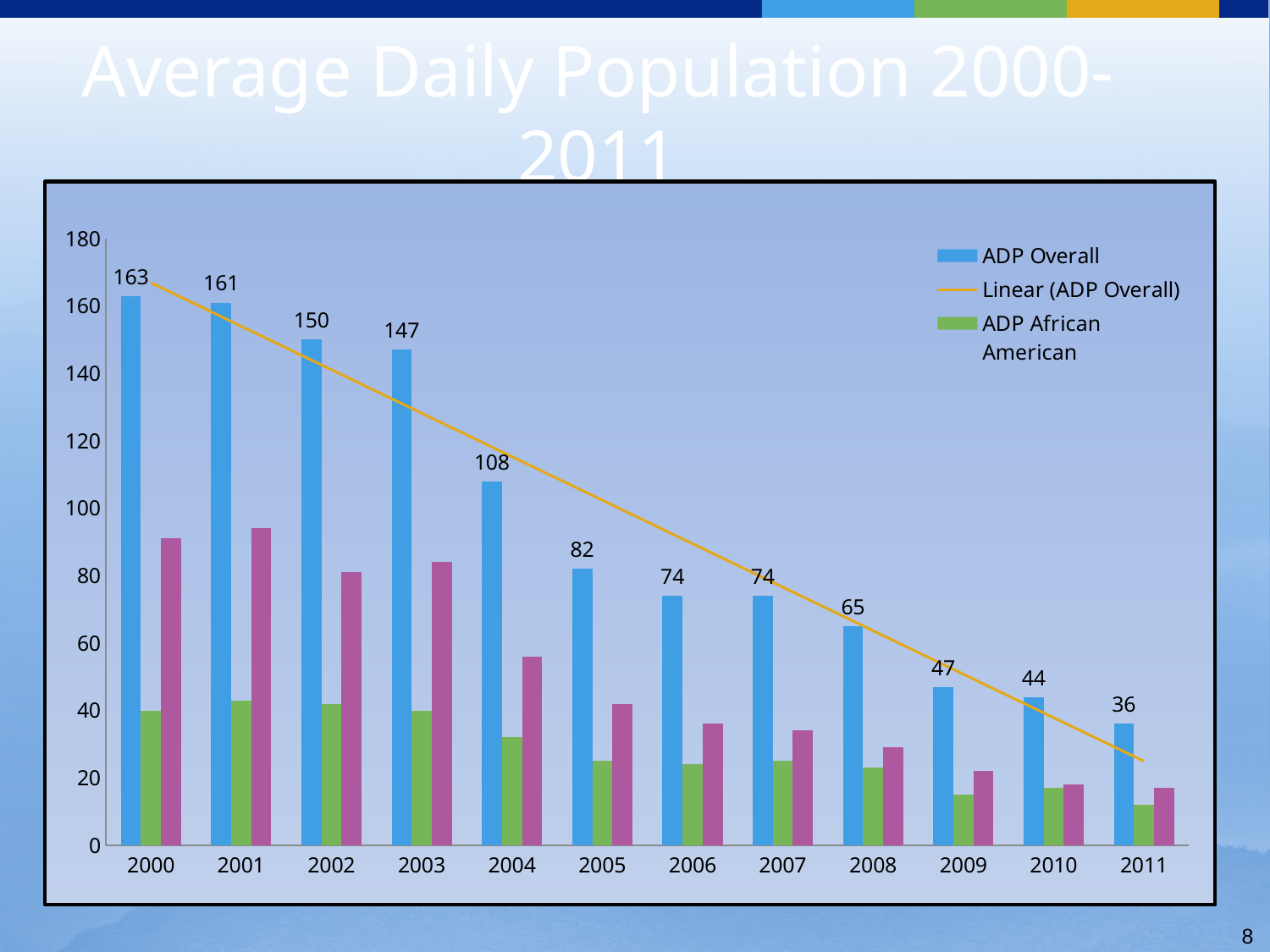
What is the ADP Overall value for 2000? 163 Which year has the lowest ADP Overall value? 2011 What is the ADP Overall value for 2004? 108 Which is larger, the ADP Overall value for 2005 or for 2008? 2005 How many years are shown on the x axis? 12 Is the ADP African American value for 2000 greater or less than 60? less What is the ADP Overall value for 2011? 36 What is the difference between the ADP Overall values for 2000 and 2011? 127 Which year has the highest ADP Overall value? 2000 What kind of chart is shown on the slide? bar chart How many entries does the legend list? 3 Do the ADP Overall values generally rise or fall from 2000 to 2011? fall